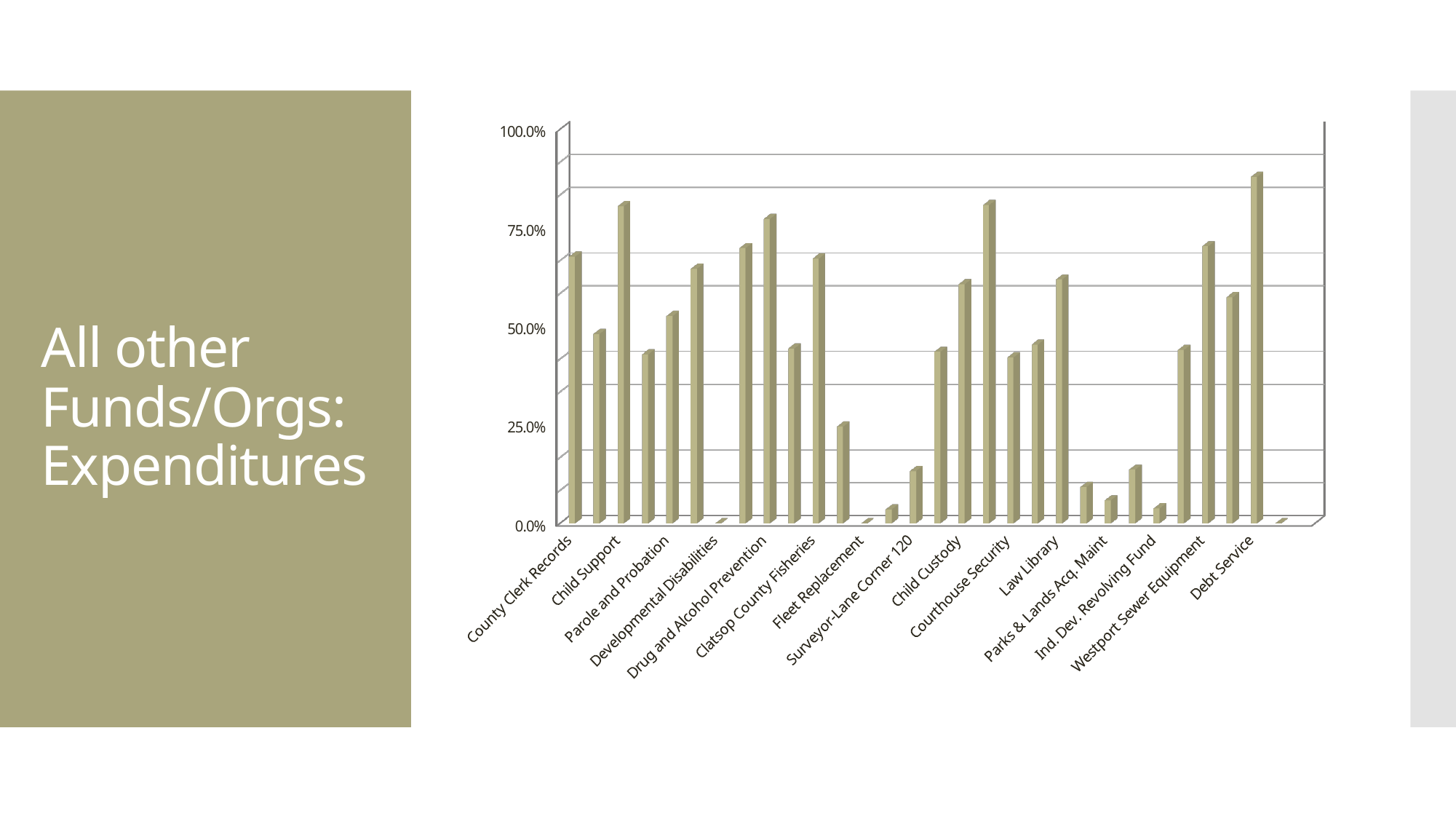
What is the highest value shown on the vertical axis of the chart? 100.0% Is the value for Parks & Lands Acq. Maint greater or less than 25.0%? less Is the value for Debt Service greater or less than 75.0%? greater Which is larger, the value for Westport Sewer Equipment or the value for Ind. Dev. Revolving Fund? Westport Sewer Equipment Which is larger, the value for Child Support or the value for Parole and Probation? Child Support What kind of chart is shown on the slide? bar chart Which labeled category has the highest value in the chart? Debt Service Is the value for Fleet Replacement greater or less than 25.0%? less